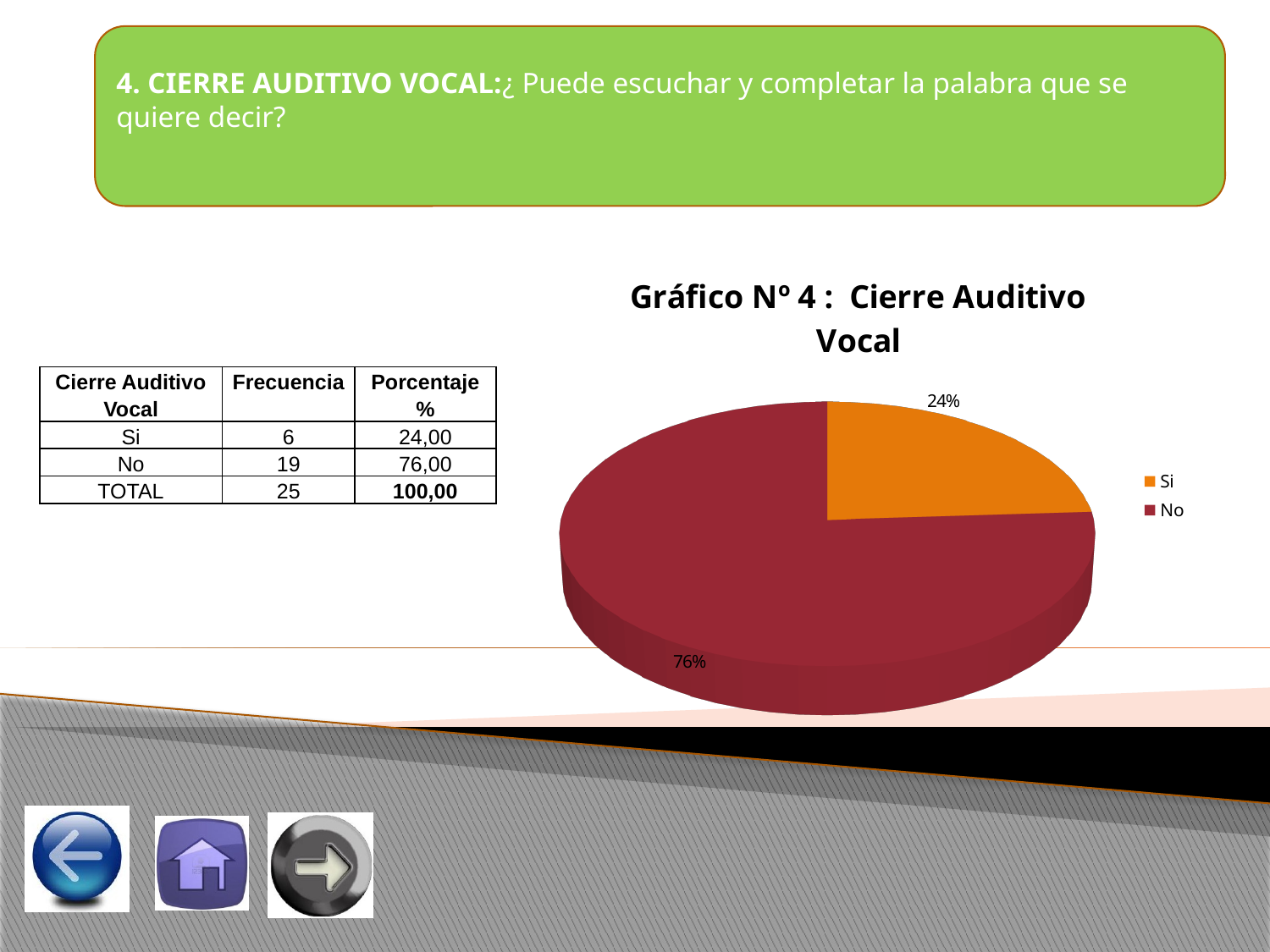
What percentage does the 'No' slice show? 76% What kind of chart is shown on the slide? Pie chart How many entries does the legend list? 2 Which category has the largest slice of the pie? No Which slice is larger, 'Si' or 'No'? No What colour is the 'No' slice in the pie chart? Dark red Which category has the smallest slice of the pie? Si What is the title of the chart? Gráfico Nº 4 : Cierre Auditivo Vocal How many slices does the pie chart have? 2 What is the difference in percentage points between the 'No' slice and the 'Si' slice? 52 What share of the pie does the 'Si' slice represent? 24% What percentage does the 'Si' slice show? 24%